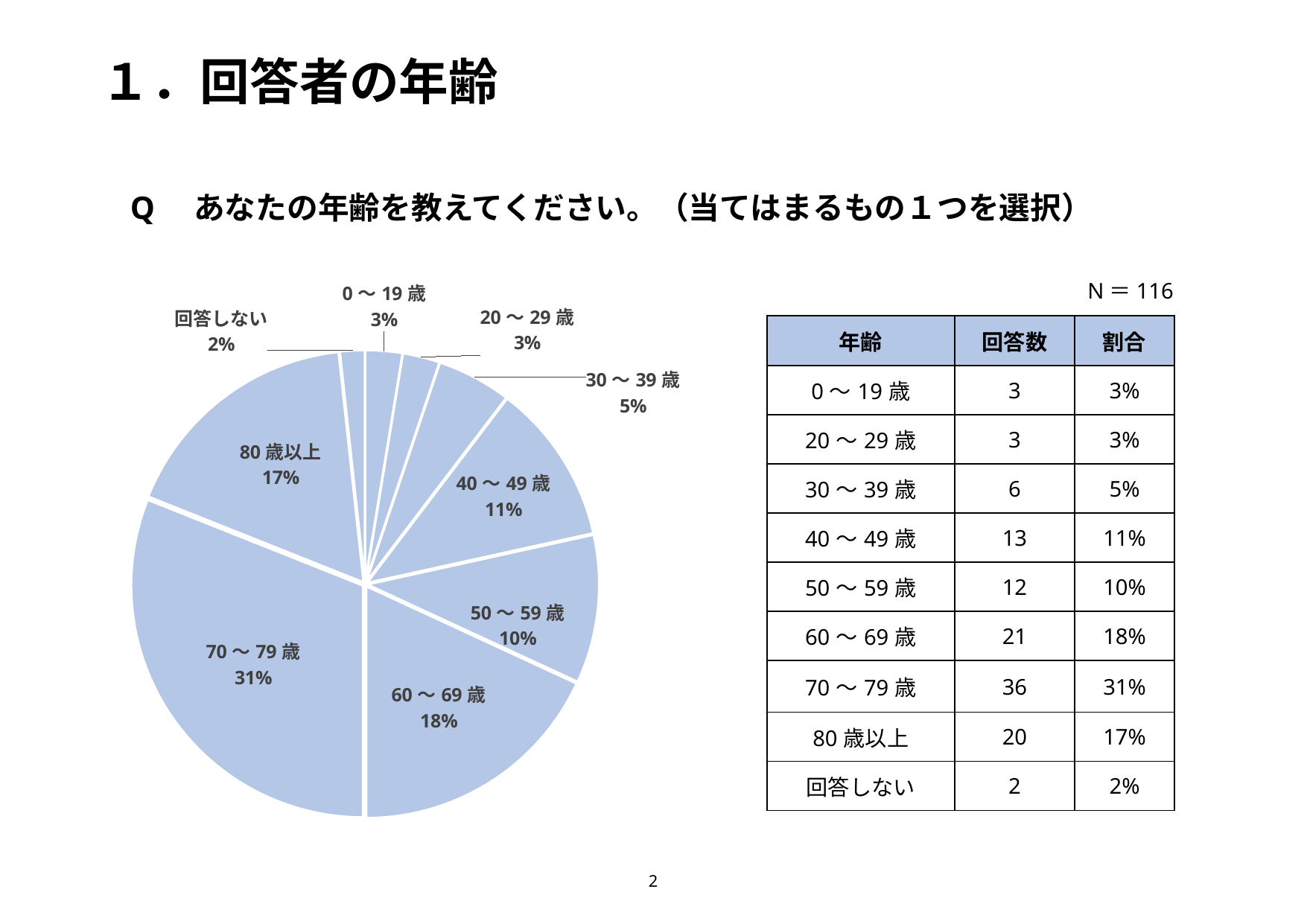
Which slice is larger, 40～49歳 or 50～59歳? 40～49歳 What percentage is shown for the 80歳以上 slice? 17% What is the N value shown next to the table on the slide? 116 What percentage is shown for the 30～39歳 slice? 5% How many slices does the pie chart have? 9 What share of the pie does the 70～79歳 slice represent? 31% Which age group has the largest slice of the pie? 70～79歳 What is the difference in percentage points between the 70～79歳 slice and the 60～69歳 slice? 13 What percentage is shown for the 60～69歳 slice? 18% What kind of chart is shown on the slide? pie chart Which category has the smallest slice of the pie? 回答しない What is the combined percentage of the 0～19歳 and 20～29歳 slices? 6%